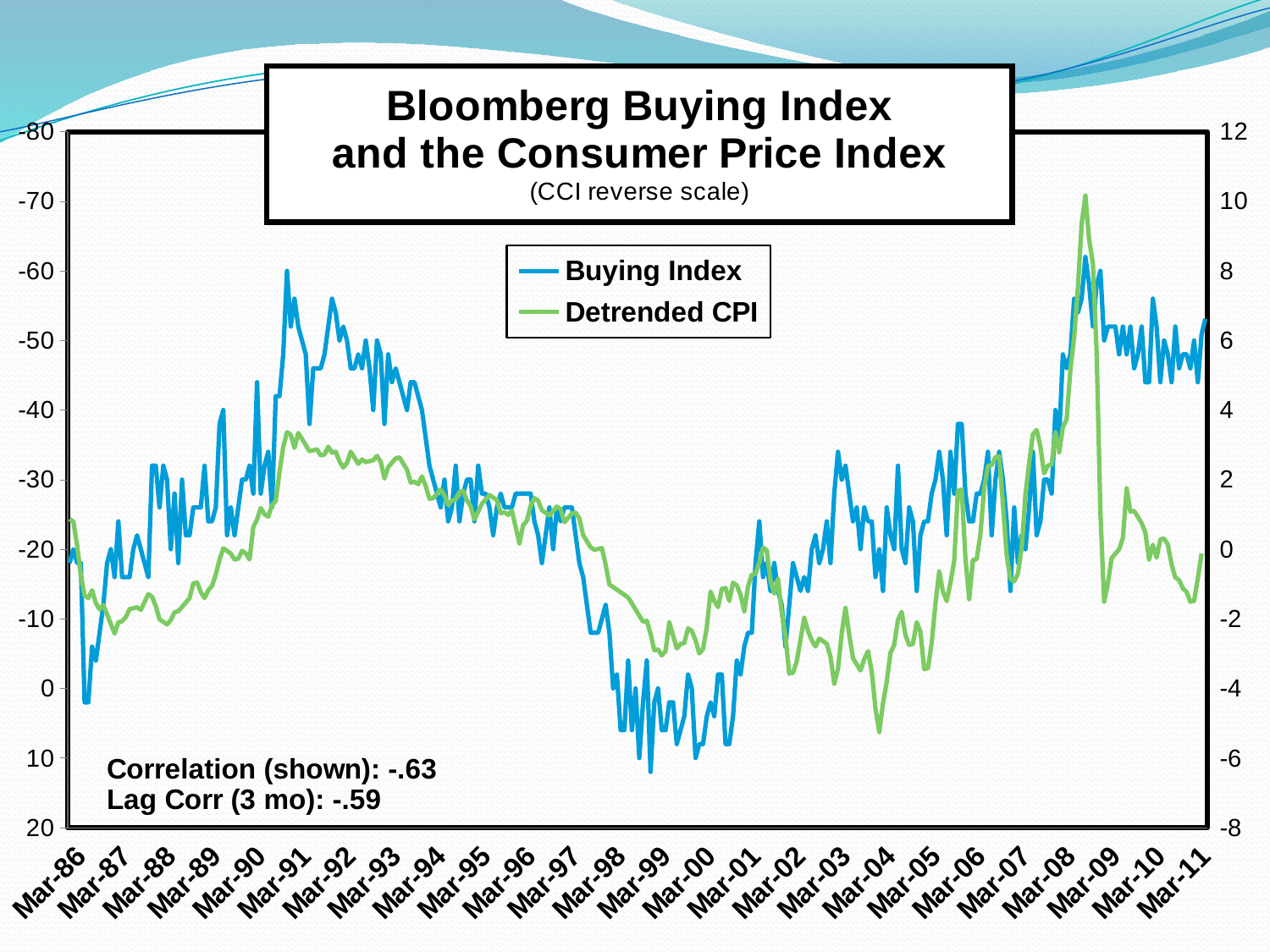
Is the Detrended CPI value at Mar-92 greater or less than 2 on the right axis? greater Is the Detrended CPI value at Mar-99 greater or less than 0 on the right axis? less What correlation value is shown in the annotation on the chart? -.63 Is the peak value of the Detrended CPI series around Mar-08 greater or less than 8 on the right axis? greater What are the two series named in the legend? Buying Index and Detrended CPI What kind of chart is shown on the slide? line chart How many series does the legend list? 2 How many date labels are shown along the x axis? 26 Does the Detrended CPI series rise or fall between Mar-86 and Mar-91? rises